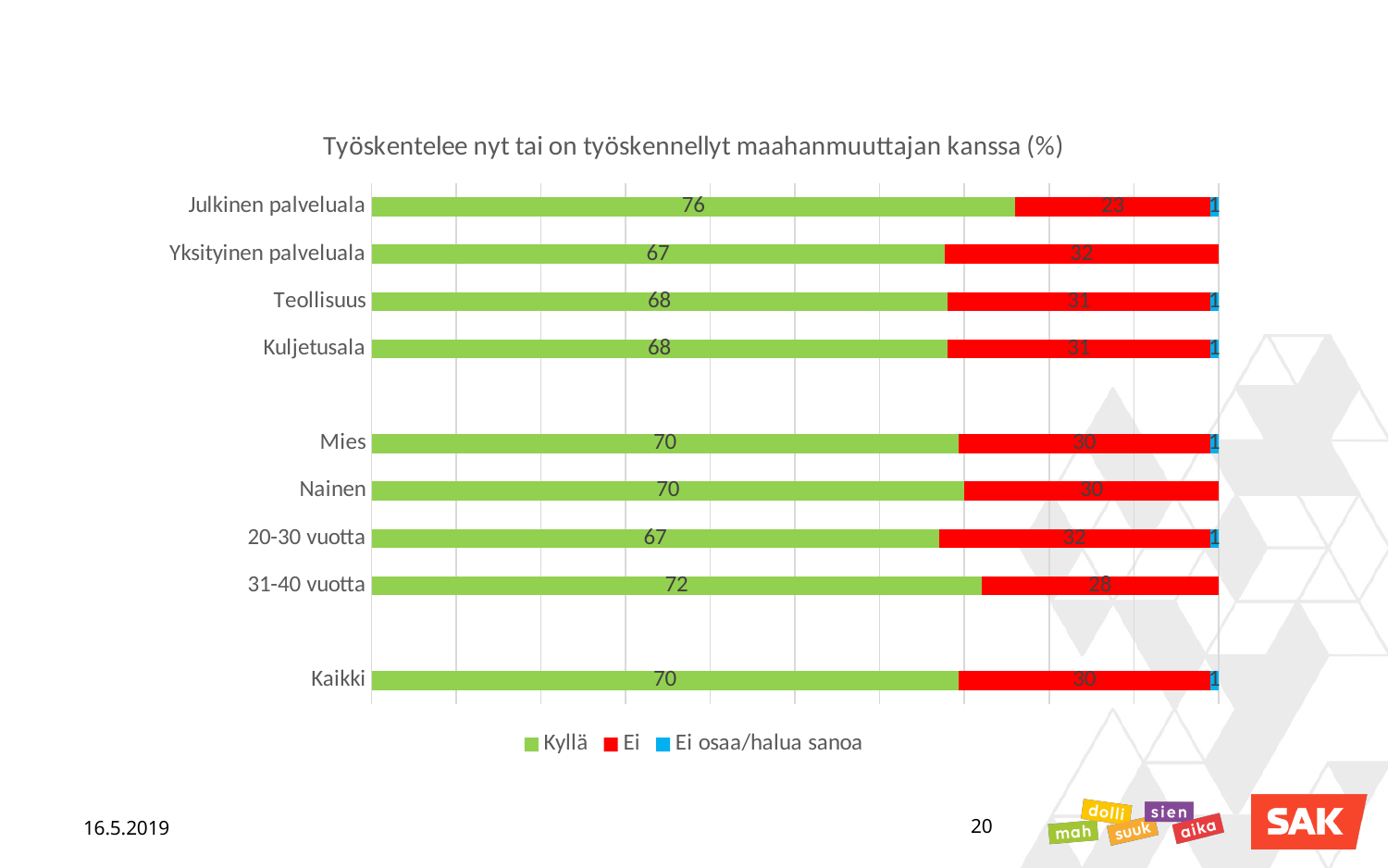
What is the Kyllä value for Julkinen palveluala? 76 How many categories are shown on the chart? 9 Which category has the highest Kyllä value? Julkinen palveluala How many series does the legend list? 3 Which is larger, the Kyllä value for 31-40 vuotta or for 20-30 vuotta? 31-40 vuotta What is the Ei value for Kaikki? 30 What is the Ei value for Yksityinen palveluala? 32 What kind of chart is shown on the slide? Stacked bar chart What is the difference between the Kyllä values for Julkinen palveluala and Yksityinen palveluala? 9 What is the total of the stacked bar for Teollisuus? 100 Which category has the lowest Ei value? Julkinen palveluala What is the Kyllä value for 31-40 vuotta? 72